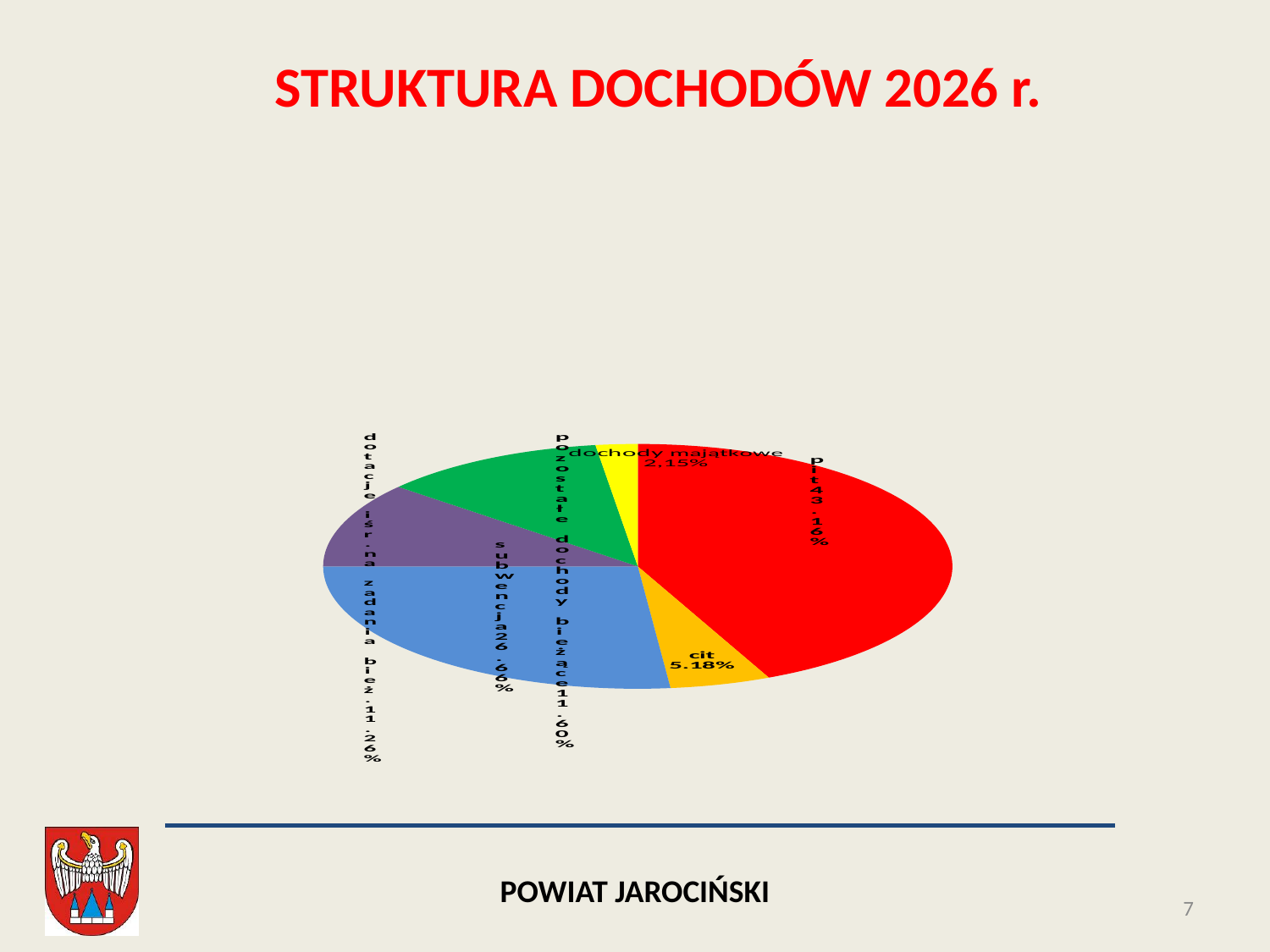
What is the difference in percentage points between the pit slice and the cit slice? 37.98% What kind of chart is shown on the slide? pie chart How many slices does the pie chart have? 6 Which slice is larger, subwencja or cit? subwencja Which category has the largest slice of the pie? pit What is the title of the chart on the slide? STRUKTURA DOCHODÓW 2026 r. What share of the pie is labelled for pit? 43.16% What share of the pie is labelled for cit? 5.18% What share of the pie is labelled for dochody majątkowe? 2,15% Which category has the smallest slice of the pie? dochody majątkowe What share of the pie is labelled for subwencja? 26.66% What share of the pie is labelled for pozostałe dochody bieżące? 11.60%